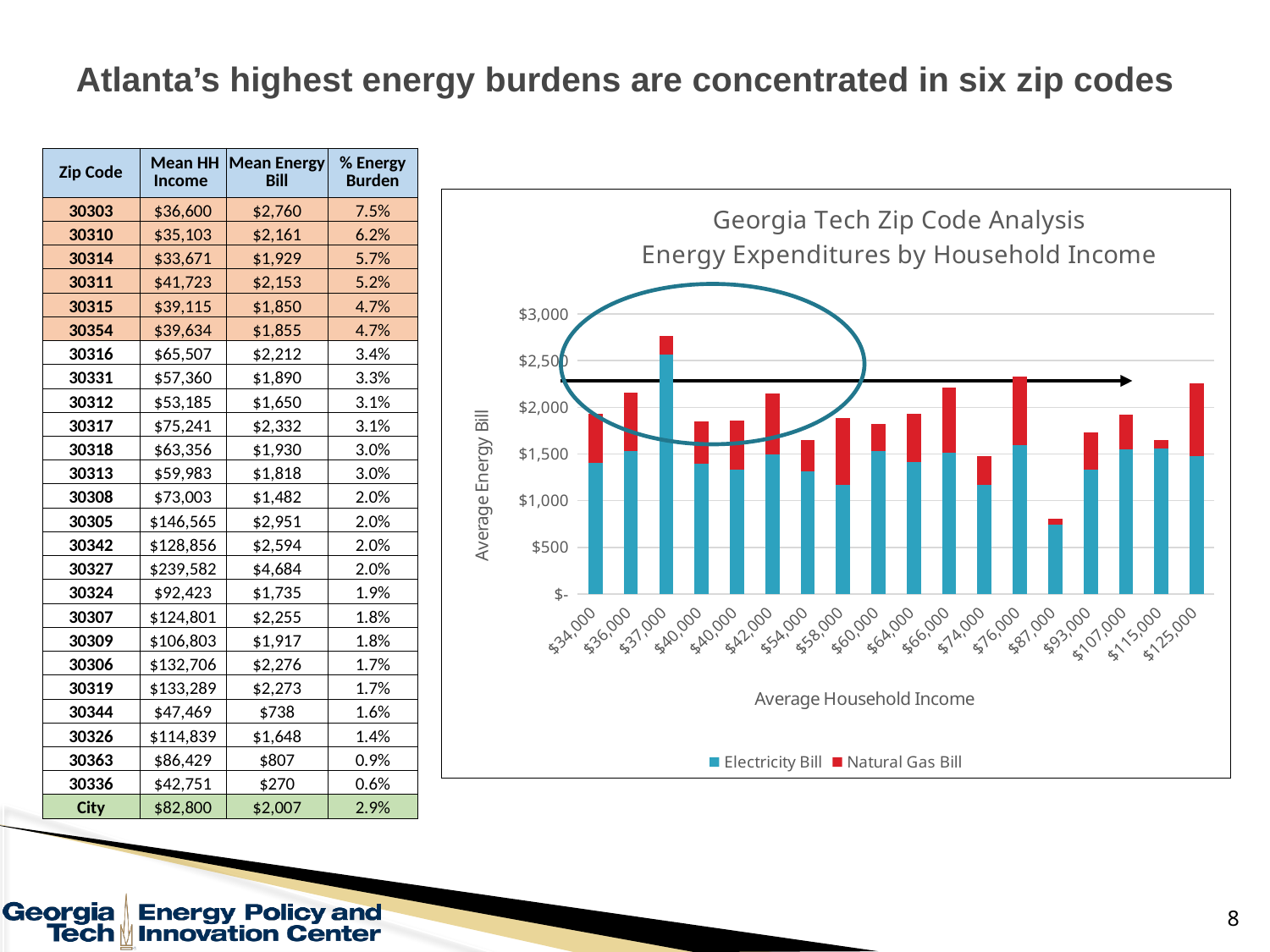
Is the total average energy bill for the $37,000 income category greater or less than $2,500? greater How many series does the chart legend list? 2 Is the total average energy bill for the $76,000 income category greater or less than $2,000? greater Is the total average energy bill for the $87,000 income category greater or less than $1,000? less What kind of chart is shown on the slide? Stacked bar chart Which household income category has the lowest total average energy bill in the chart? $87,000 Which series in the chart is shown in red? Natural Gas Bill Which has the larger total average energy bill in the chart: the $37,000 or the $87,000 income category? $37,000 What is the title of the chart? Georgia Tech Zip Code Analysis Energy Expenditures by Household Income How many household income categories are plotted along the x axis of the chart? 18 Which household income category has the highest total average energy bill in the chart? $37,000